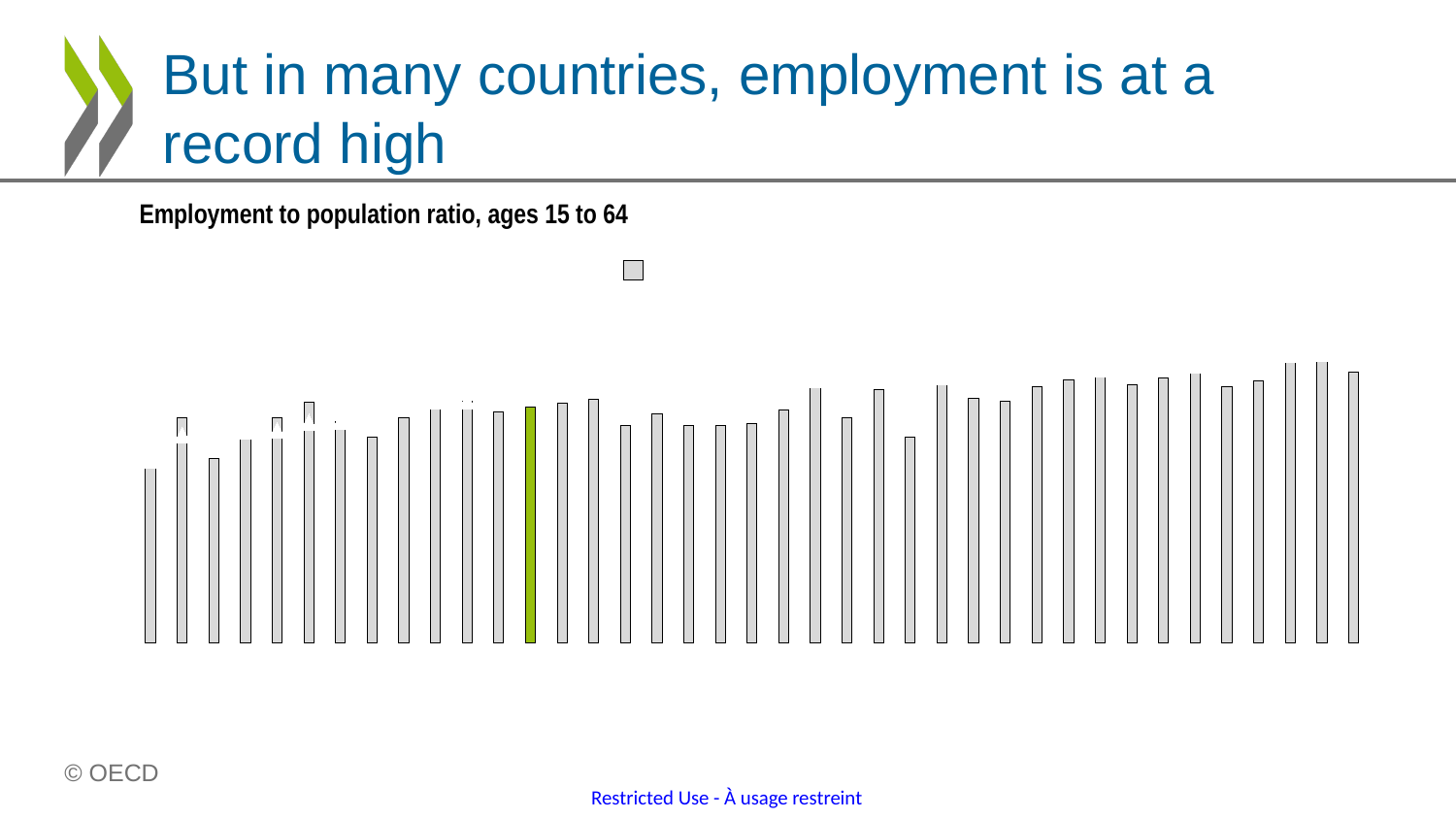
Is the green highlighted bar taller or shorter than the leftmost bar? taller Which is taller, the leftmost bar or the rightmost bar? the rightmost bar What colour is the single highlighted bar in the chart? green What is the title of the chart on the slide? Employment to population ratio, ages 15 to 64 What kind of chart is shown on the slide? bar chart Is the tallest bar located in the left half or the right half of the chart? right half Do the bars generally rise or fall from left to right across the chart? rise Is the shortest bar located in the left half or the right half of the chart? left half